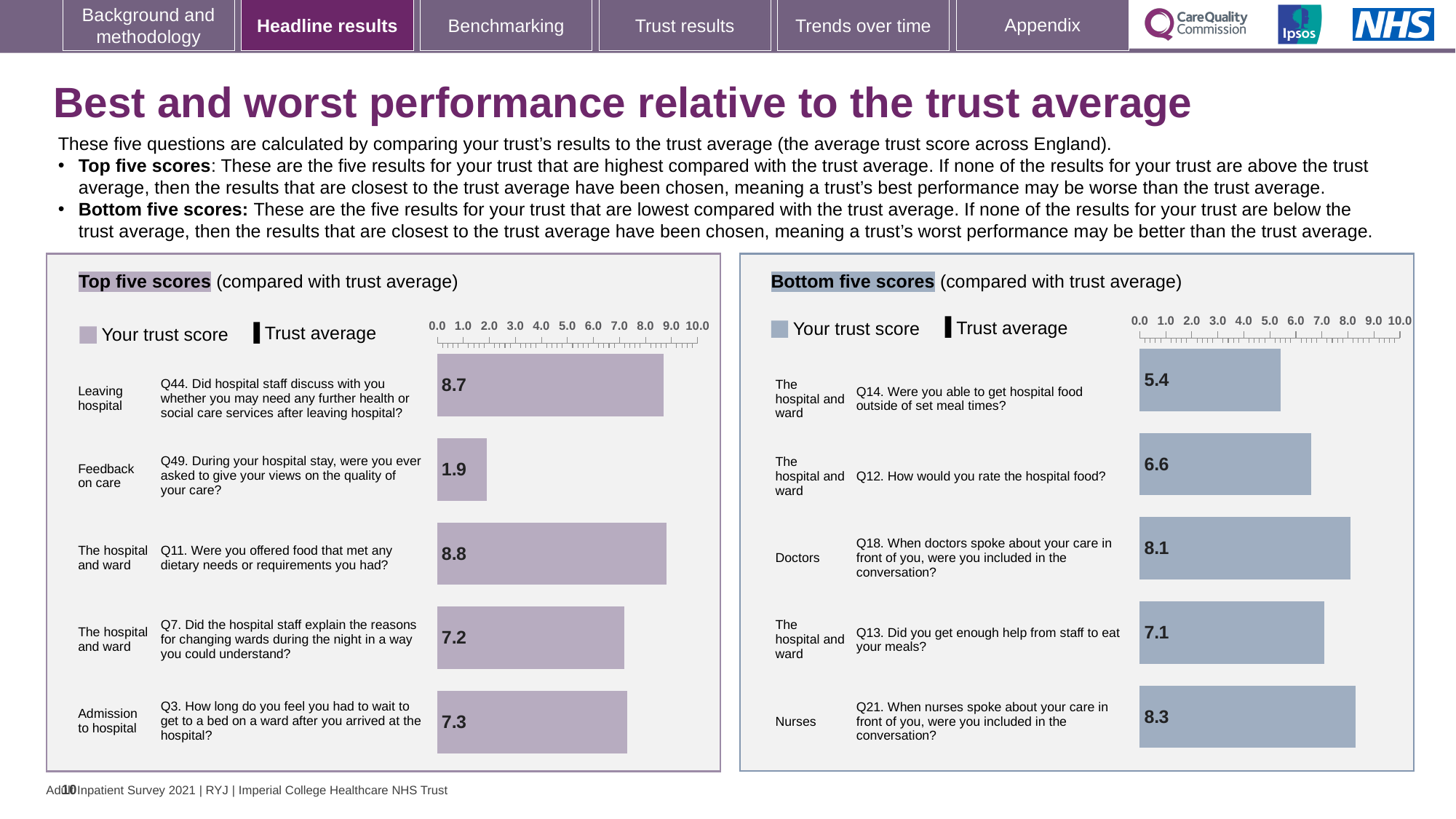
In the Bottom five scores chart, which question has the highest trust score? Q21 In the Top five scores chart, what is the trust score for Q44 about discussing further health or social care services after leaving hospital? 8.7 In the Top five scores chart, what is the trust score for Q3 about waiting to get a bed on a ward? 7.3 In the Top five scores chart, which question has the lowest trust score? Q49 In the Bottom five scores chart, which question has the lowest trust score? Q14 In the Bottom five scores chart, what is the trust score for Q12, how would you rate the hospital food? 6.6 What are the two legend entries shown in the Top five scores chart? Your trust score; Trust average In the Top five scores chart, which has the larger score, Q7 or Q3? Q3 In the Bottom five scores chart, is the score for Q14 greater or less than 6.0? less In the Bottom five scores chart, what is the difference between the scores for Q12 and Q14? 1.2 How many questions are shown in the Top five scores chart? 5 What kind of chart is used in the Bottom five scores panel? Bar chart